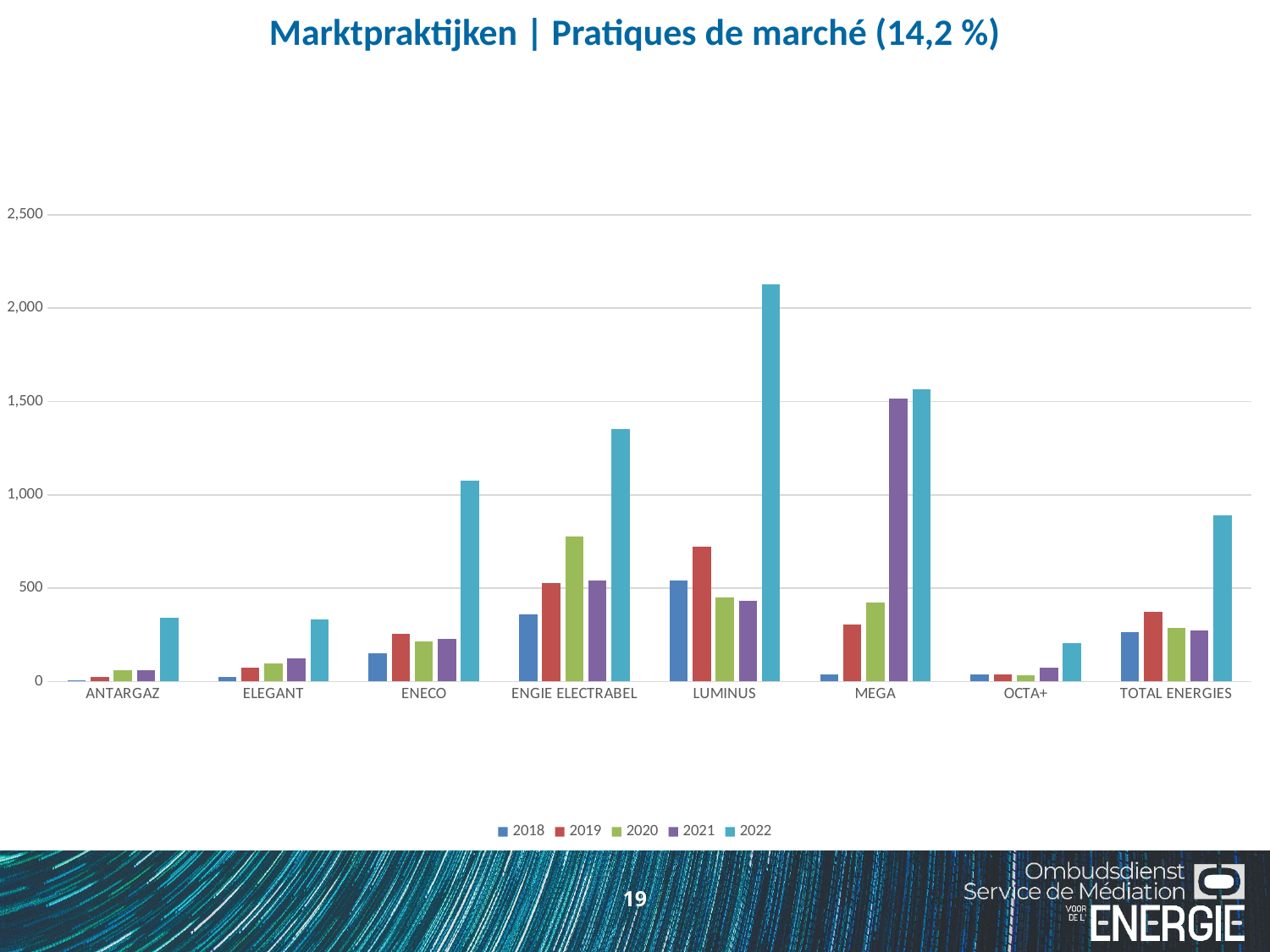
Is the value for ENECO in 2022 greater or less than 1,000? greater Which supplier has the highest bar for 2022? LUMINUS How many series does the legend list? 5 Is the value for TOTAL ENERGIES in 2022 greater or less than 1,000? less What is the title of the chart on the slide? Marktpraktijken | Pratiques de marché (14,2 %) For ENGIE ELECTRABEL, which is larger: the 2019 value or the 2020 value? 2020 Is the value for LUMINUS in 2022 greater or less than 2,000? greater What kind of chart is shown on the slide? bar chart Which supplier has the lowest bar for 2022? OCTA+ Which is larger for 2019: LUMINUS or ENGIE ELECTRABEL? LUMINUS How many categories (suppliers) are shown on the x axis? 8